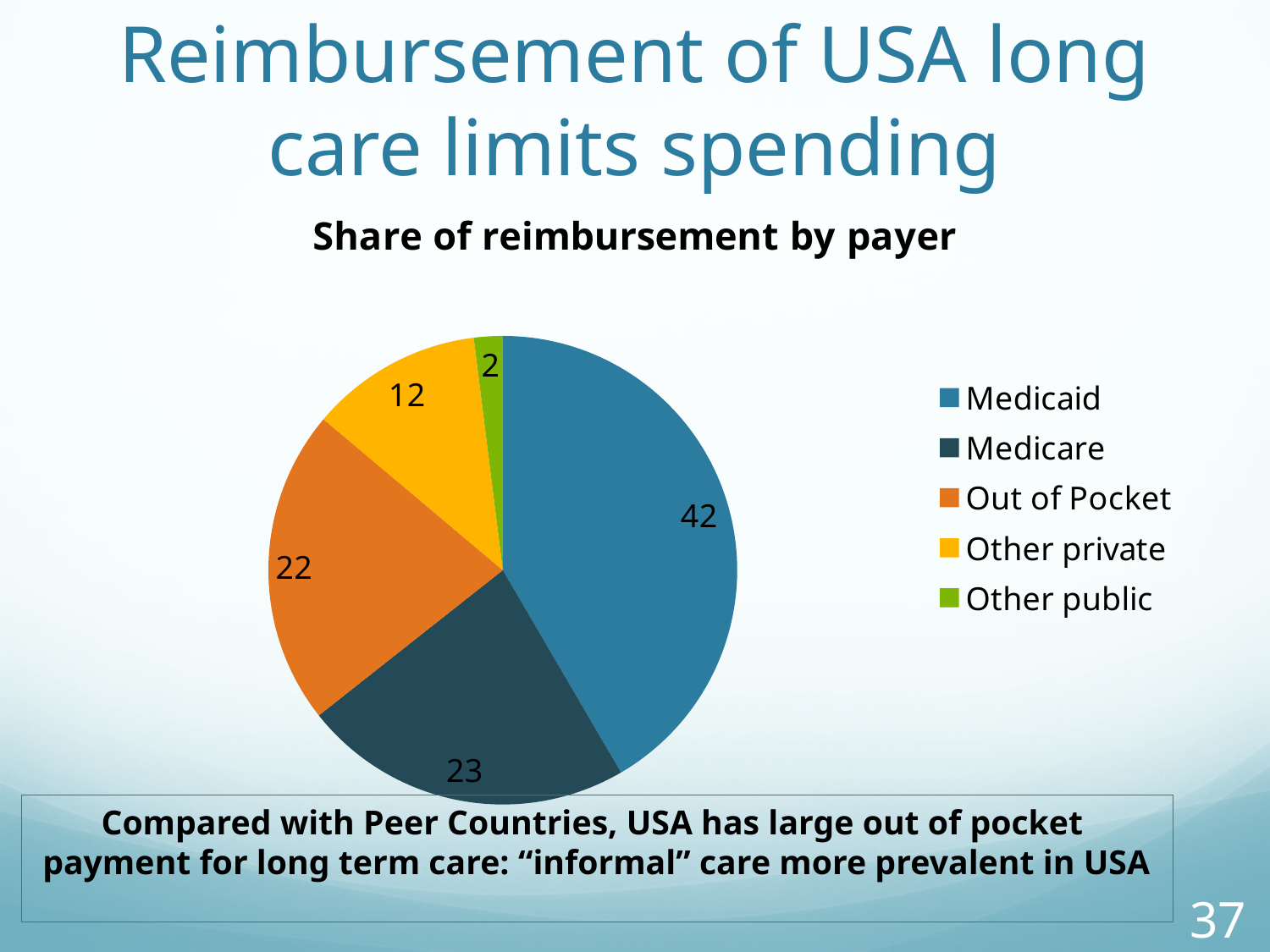
Which payer has the largest slice of the pie? Medicaid How many payer categories does the pie chart show? 5 What value is shown for Other public? 2 Which is larger, the value for Medicaid or the value for Other private? Medicaid What value is shown for Medicare? 23 What type of chart is shown on the slide? pie chart What value is shown for Other private? 12 What value is shown for Medicaid? 42 What is the title of the chart? Share of reimbursement by payer What is the difference between the Medicaid value and the Medicare value? 19 What value is shown for Out of Pocket? 22 Which payer has the smallest slice of the pie? Other public